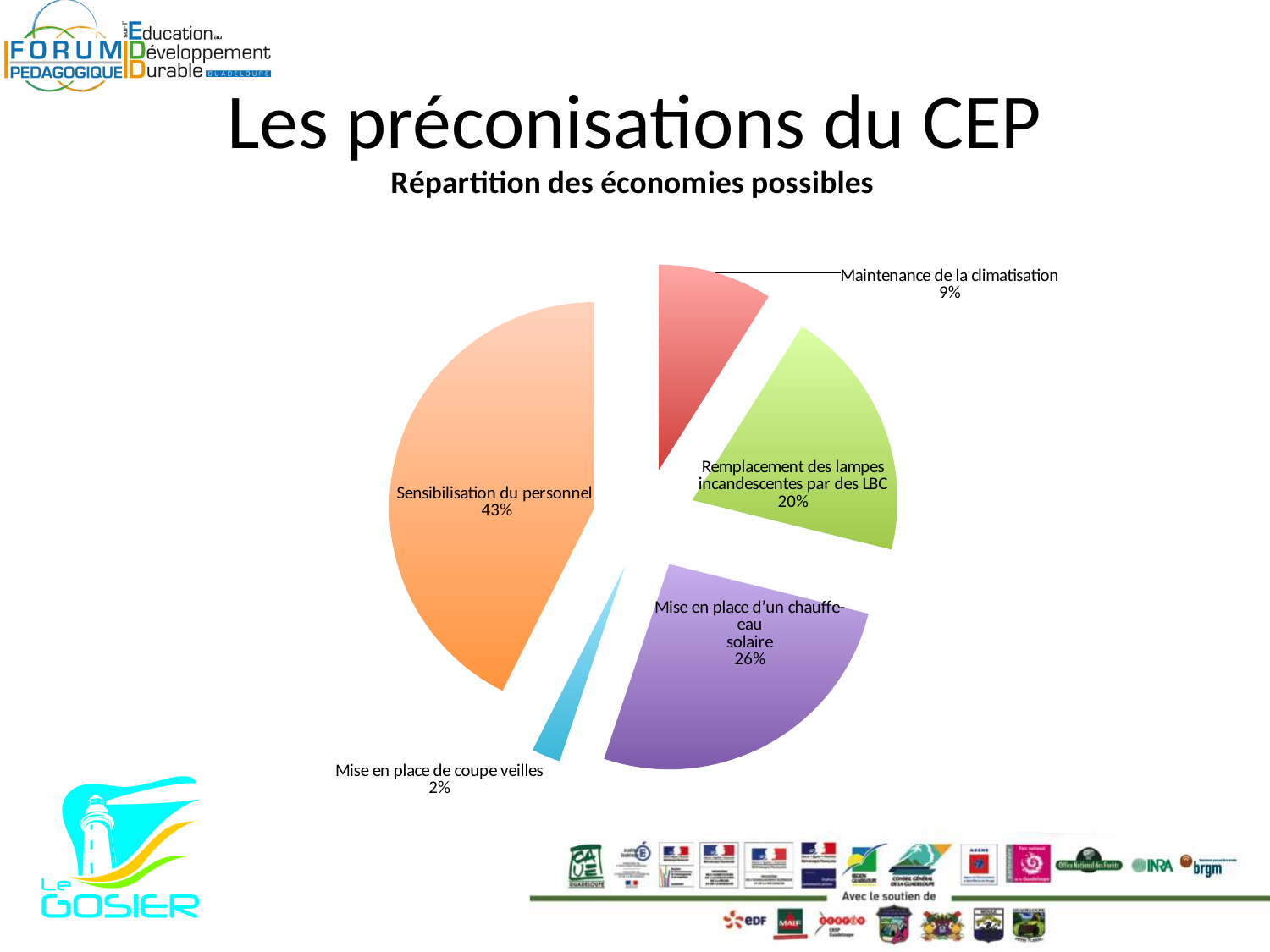
What share of the pie does 'Remplacement des lampes incandescentes par des LBC' represent? 20% Which is larger: the share for 'Remplacement des lampes incandescentes par des LBC' or for 'Maintenance de la climatisation'? Remplacement des lampes incandescentes par des LBC What is the title of the chart? Répartition des économies possibles What share of the pie does 'Mise en place de coupe veilles' represent? 2% What kind of chart is shown on the slide? pie chart Which category has the smallest share of the pie? Mise en place de coupe veilles Which category has the largest share of the pie? Sensibilisation du personnel What is the difference in percentage points between 'Sensibilisation du personnel' and 'Mise en place d'un chauffe-eau solaire'? 17 What share of the pie does 'Maintenance de la climatisation' represent? 9% How many slices does the pie chart have? 5